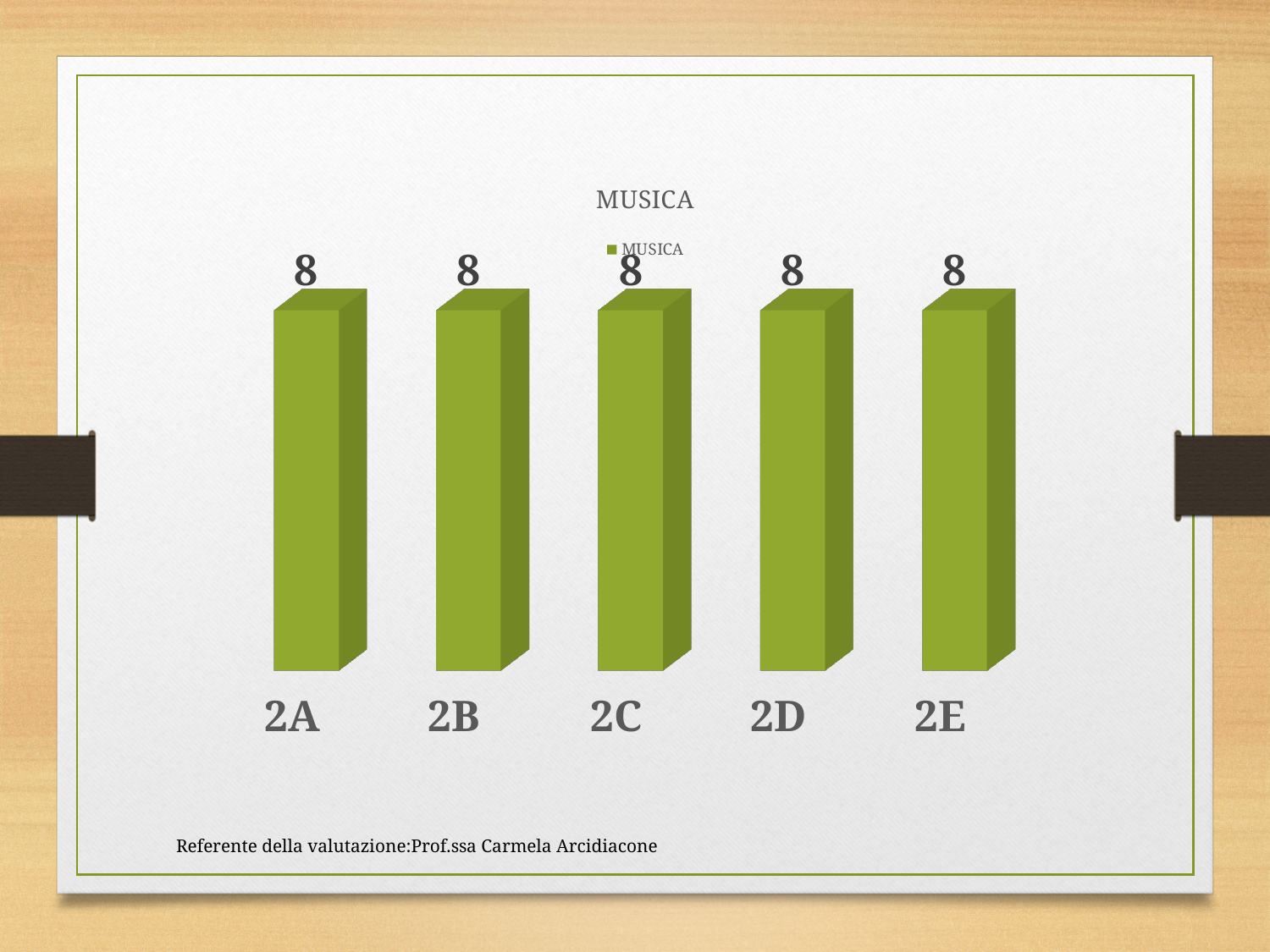
What is the value for 2A? 8 How many series does the legend list? 1 What is the title of the chart? MUSICA What is the name of the series in the legend? MUSICA What is the value for 2C? 8 Do the values rise, fall or stay the same from 2A to 2E? stay the same What is the value for 2E? 8 What is the difference between the values for 2B and 2D? 0 How many categories are shown on the x axis? 5 What kind of chart is shown? bar chart